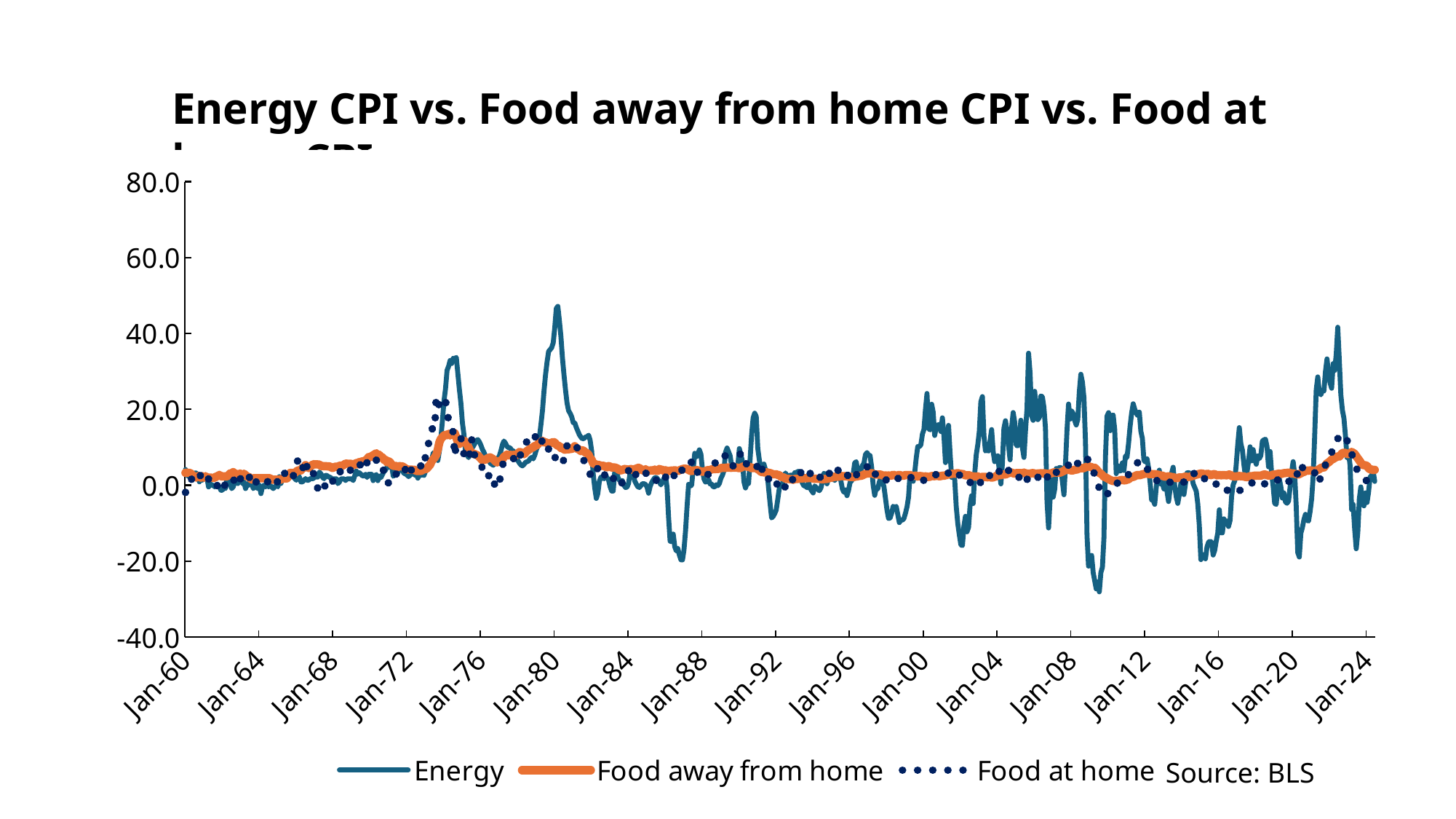
Is the peak value of the Energy series around Jan-80 greater or less than 40? greater Around Jan-80, which series is higher: Energy or Food away from home? Energy Which series reaches the highest value anywhere on the chart? Energy What kind of chart is shown on the slide? line chart What is the highest value shown on the y axis? 80.0 How many series does the legend list? 3 Is the peak value of the Energy series shortly after Jan-20 greater or less than 20? greater How many date labels are shown on the x axis? 17 What source is cited for the chart data? BLS Is the lowest value of the Energy series around Jan-08 to Jan-12 greater or less than -20? less Which series is drawn as a dotted line in the legend? Food at home